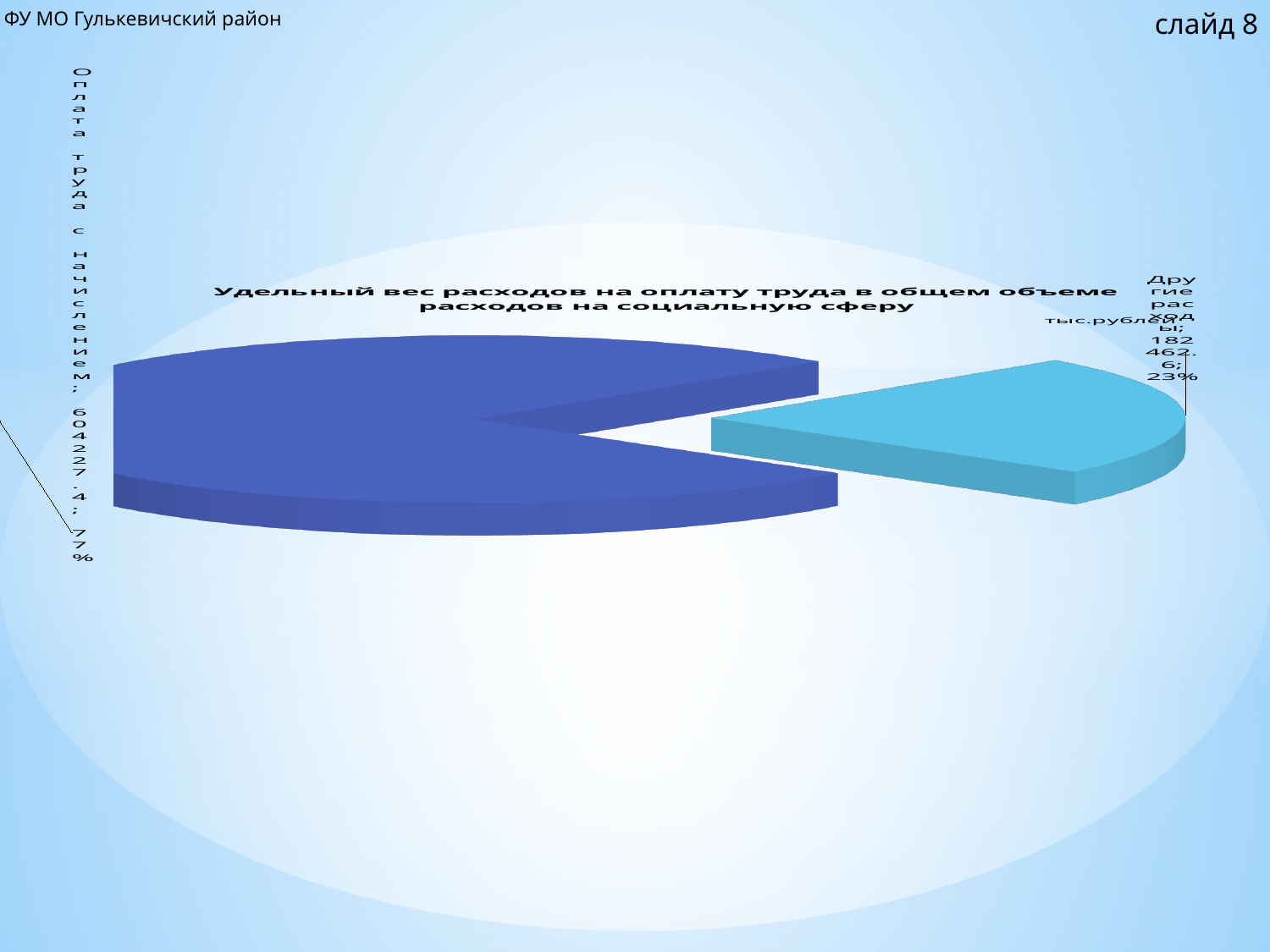
Which is larger, "Оплата труда с начислением" or "Другие расходы"? Оплата труда с начислением How many slices does the pie chart have? 2 What share of the pie does "Оплата труда с начислением" represent? 77% What is the value shown for "Оплата труда с начислением"? 604227.4 Which slice is the largest in the pie chart? Оплата труда с начислением What share of the pie does "Другие расходы" represent? 23% In what units are the values on the chart given? тыс.рублей What is the difference in percentage points between the "Оплата труда с начислением" share and the "Другие расходы" share? 54 What is the value shown for "Другие расходы"? 182462.6 What is the title of the chart? Удельный вес расходов на оплату труда в общем объеме расходов на социальную сферу What kind of chart is shown on the slide? pie chart Which slice is the smallest in the pie chart? Другие расходы